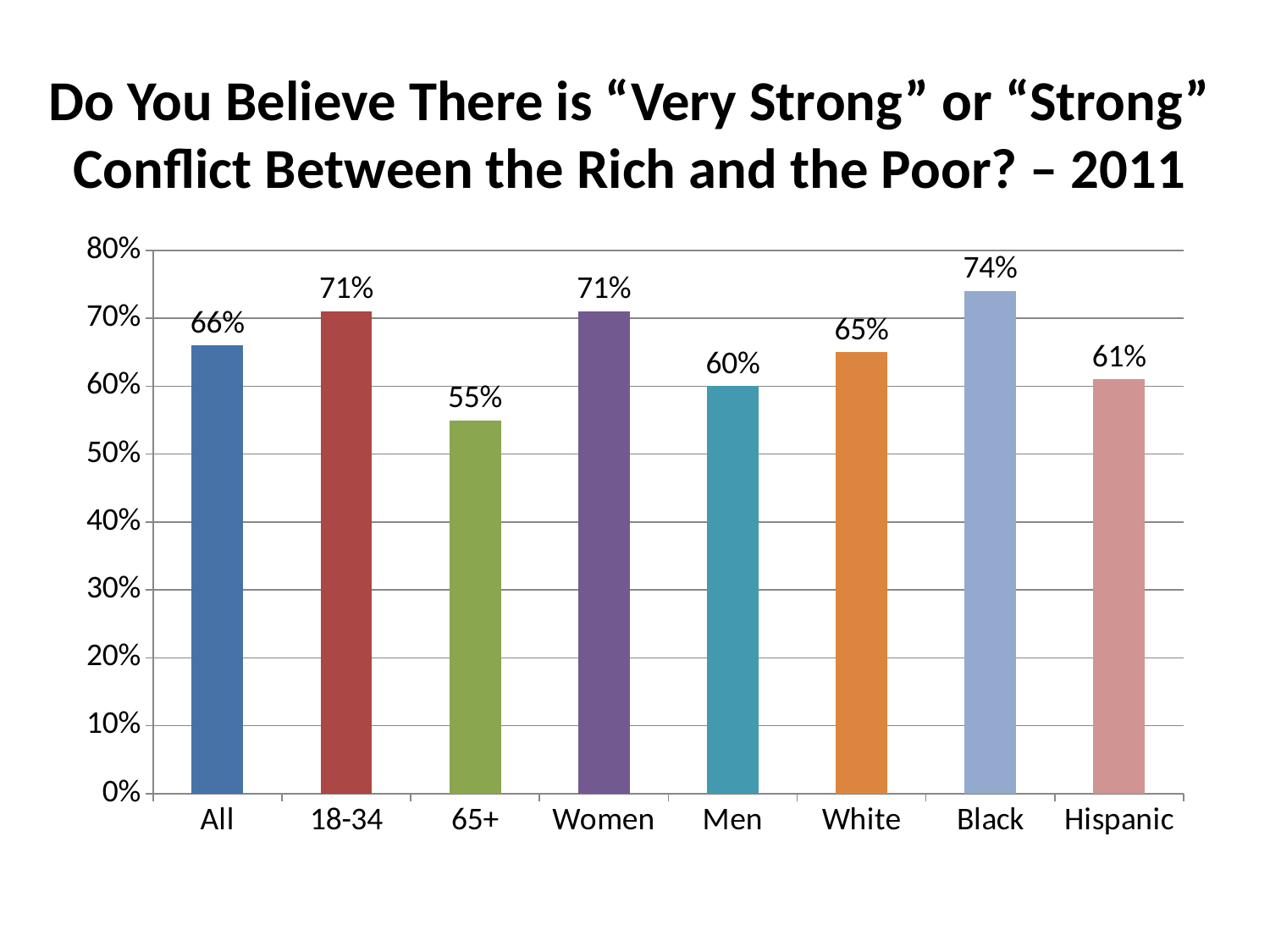
What is the value shown for the 65+ group? 55% Which group has the highest value on the chart? Black What is the difference between the values for Black and White respondents? 9% What is the difference between the values for Women and Men? 11% What is the value shown for Hispanic respondents? 61% What percentage of the 'All' group believes there is very strong or strong conflict between the rich and the poor? 66% What year is referenced in the chart title? 2011 Which group has the lowest value on the chart? 65+ What kind of chart is shown on the slide? bar chart How many groups are shown on the x axis? 8 Is the value for Men greater or less than 70%? less Which is larger, the value for 18-34 or the value for 65+? 18-34